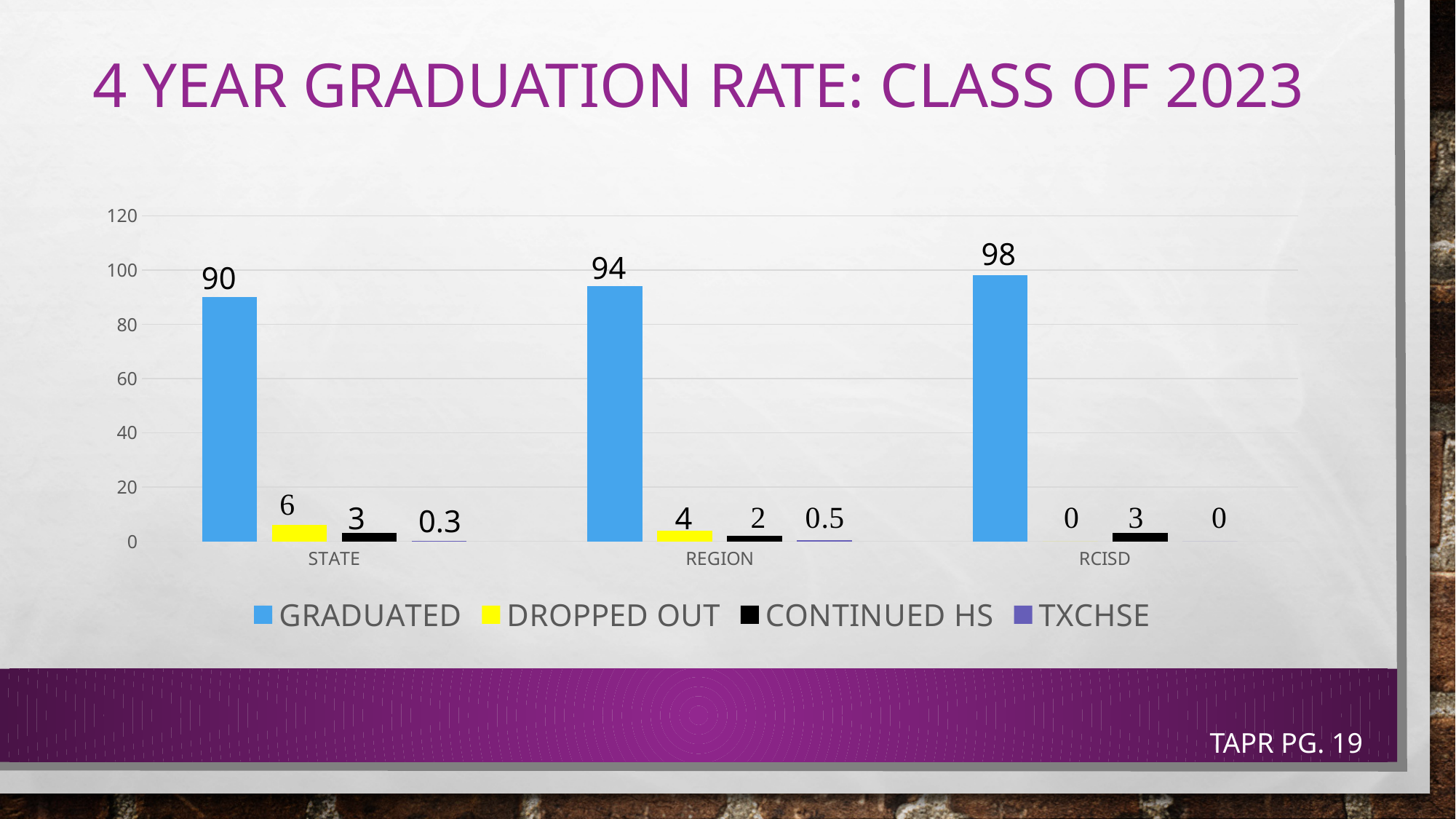
What is the TXCHSE value for Region? 0.5 How many series does the legend list? 4 What is the Dropped Out value for State? 6 Which category has the highest Graduated value? RCISD Which is larger, the Dropped Out value for State or for Region? State What is the Graduated value for RCISD? 98 Is the Graduated value for Region greater or less than 80? greater What is the difference between the Graduated values for RCISD and State? 8 What kind of chart is shown on the slide? bar chart Which category has the lowest Graduated value? State How many categories are shown on the x axis? 3 What is the Continued HS value for RCISD? 3